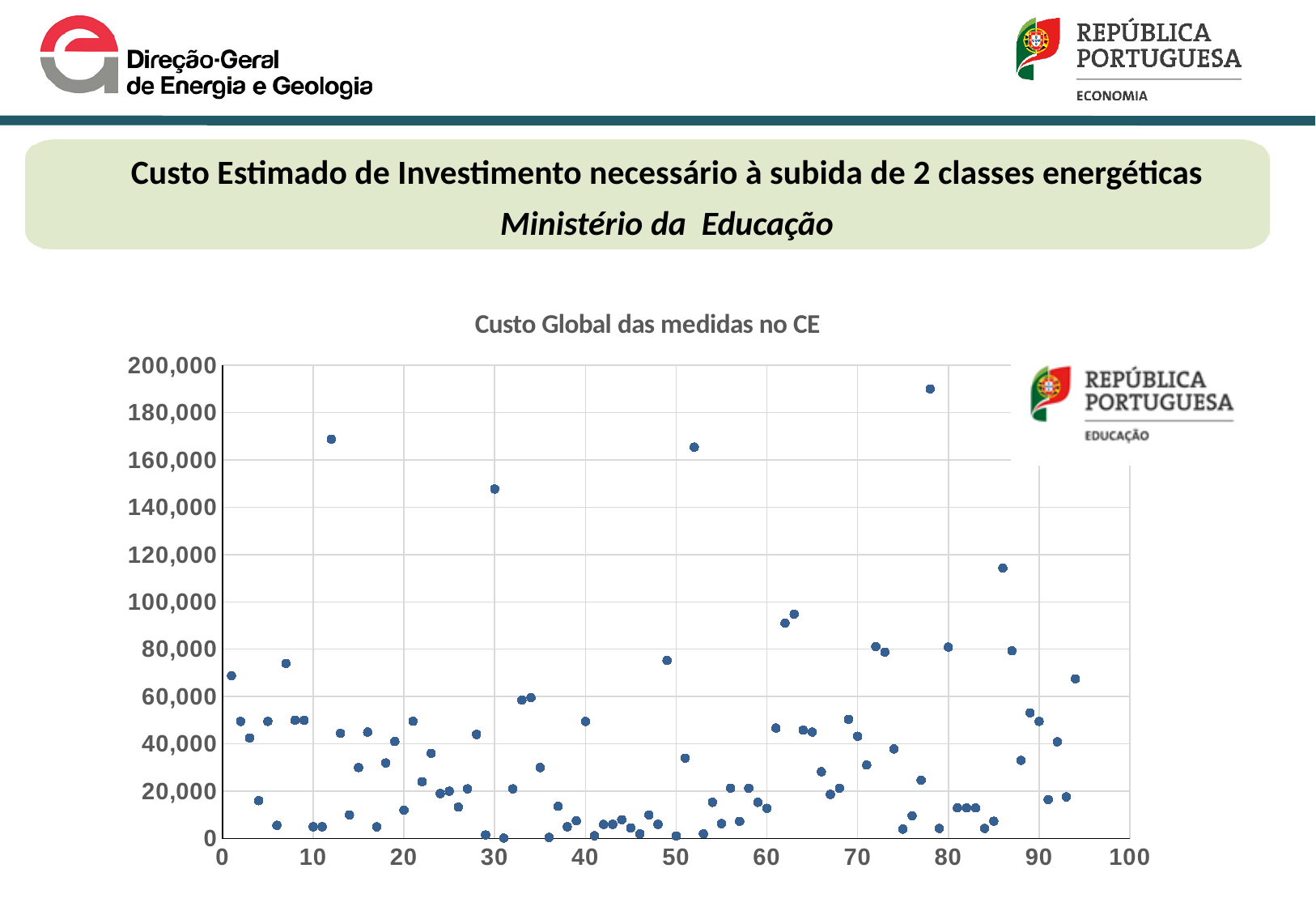
Is the plotted point near x = 86 greater or less than 100,000? greater Is the highest plotted point in the chart greater or less than 180,000? greater What kind of chart is shown on the slide? scatter chart What is the title of the chart? Custo Global das medidas no CE What is the highest value shown on the vertical axis of the chart? 200,000 How many plotted points lie above 160,000? 3 How many plotted points lie above 100,000? 5 Is the plotted point near x = 30 greater or less than 140,000? greater